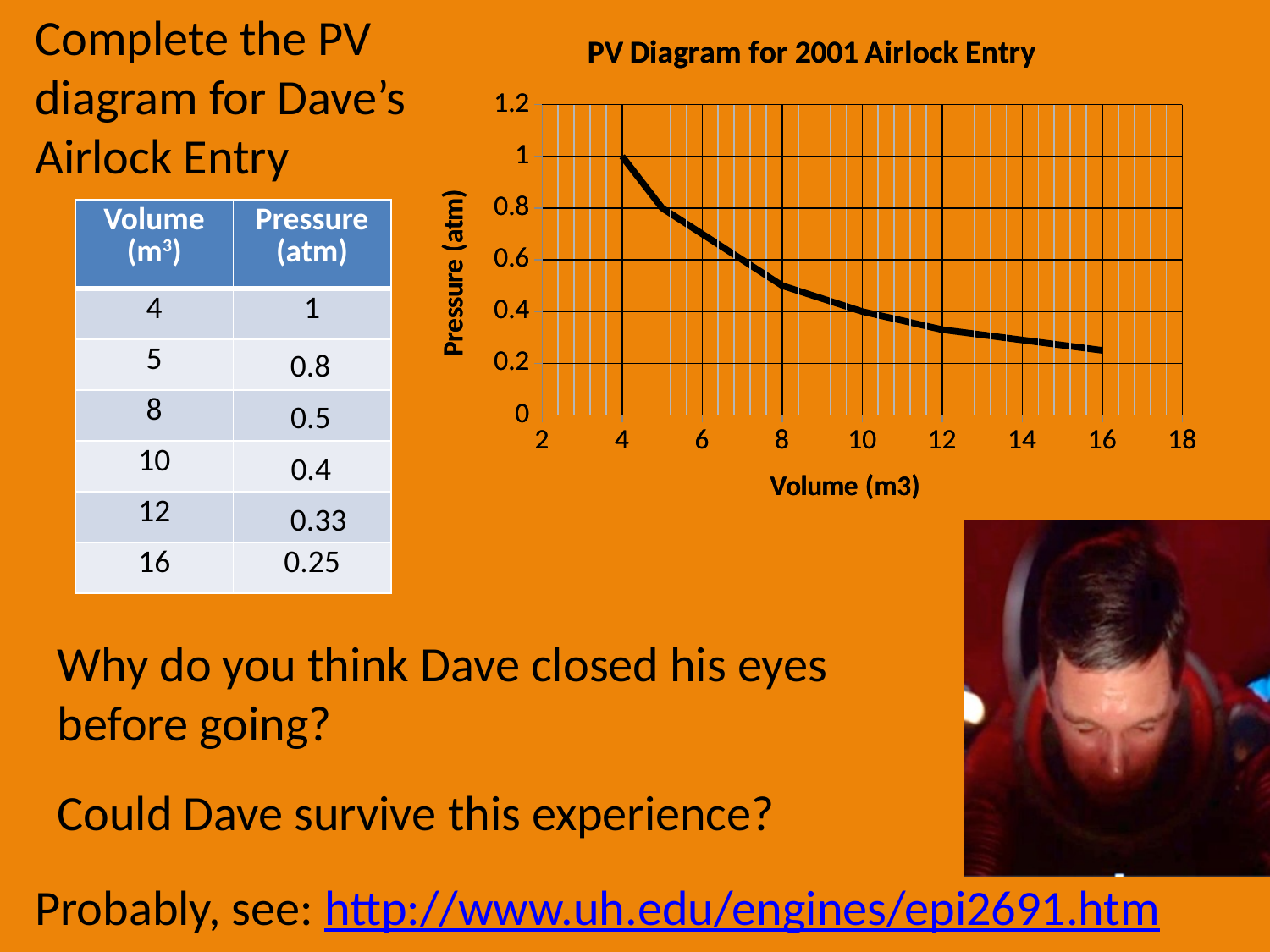
At which volume is the pressure highest? 4 What is the label of the vertical axis of the chart? Pressure (atm) At which volume is the pressure lowest? 16 Does the pressure rise or fall as volume increases along the x axis? fall What is the pressure at a volume of 4 m3? 1 What kind of chart is the PV Diagram for 2001 Airlock Entry? line chart Which has the higher pressure, a volume of 5 m3 or a volume of 10 m3? 5 How many data points are plotted on the chart? 6 What is the pressure at a volume of 5 m3? 0.8 What is the pressure at a volume of 10 m3? 0.4 Is the pressure at a volume of 8 m3 greater or less than 0.6? less What is the title of the chart? PV Diagram for 2001 Airlock Entry